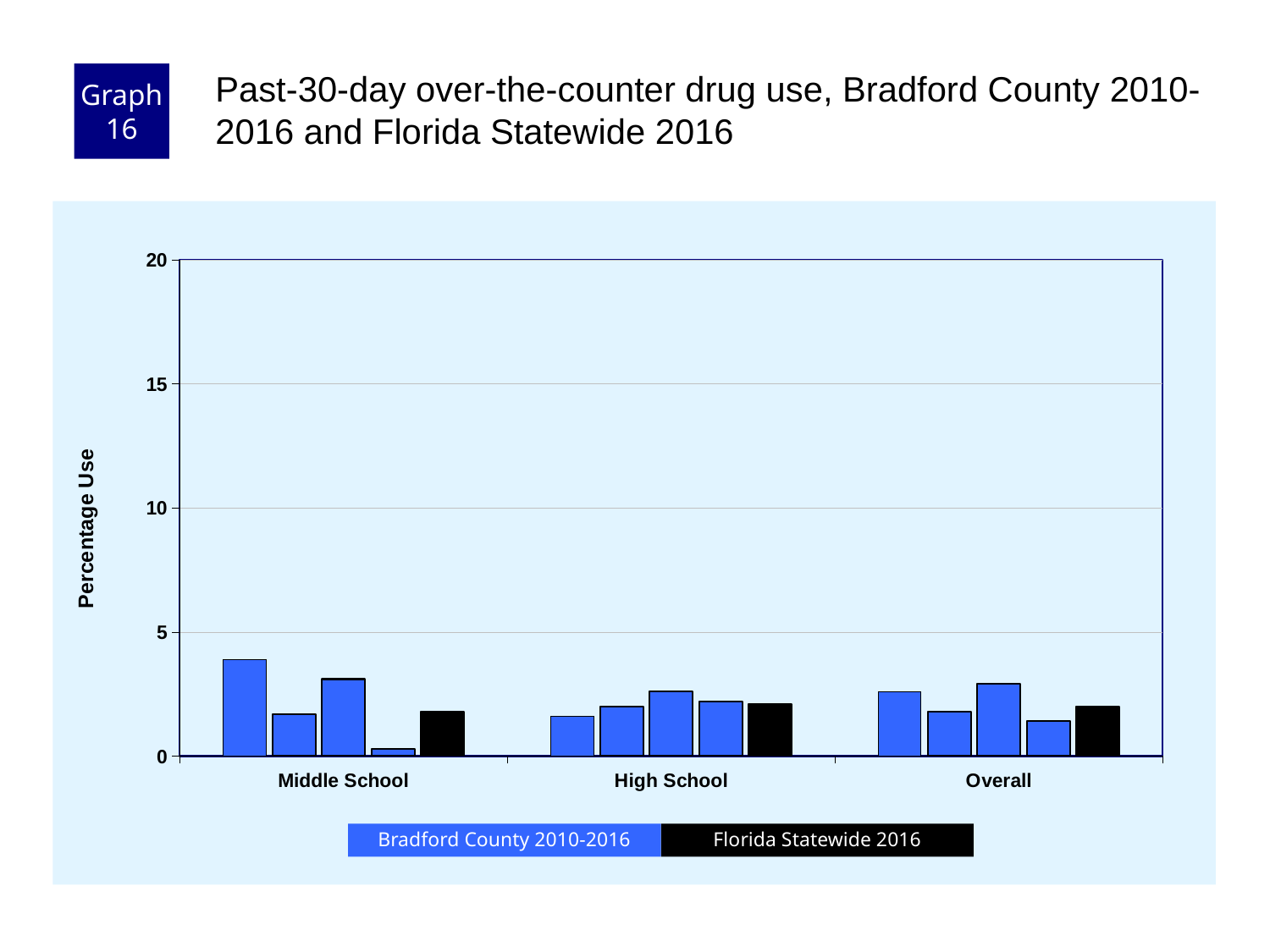
Is the Florida Statewide 2016 value for Overall greater or less than 5? less What kind of chart is shown on the slide? Bar chart What is the label on the y axis? Percentage Use Is the tallest Bradford County 2010-2016 bar for Middle School greater or less than 5? less Is the Florida Statewide 2016 value for High School greater or less than 5? less Which category contains the single tallest bar on the chart? Middle School How many series does the legend list? 2 What are the two series named in the legend? Bradford County 2010-2016 and Florida Statewide 2016 How many school-level categories are shown on the x axis? 3 Which category contains the single shortest bar on the chart? Middle School